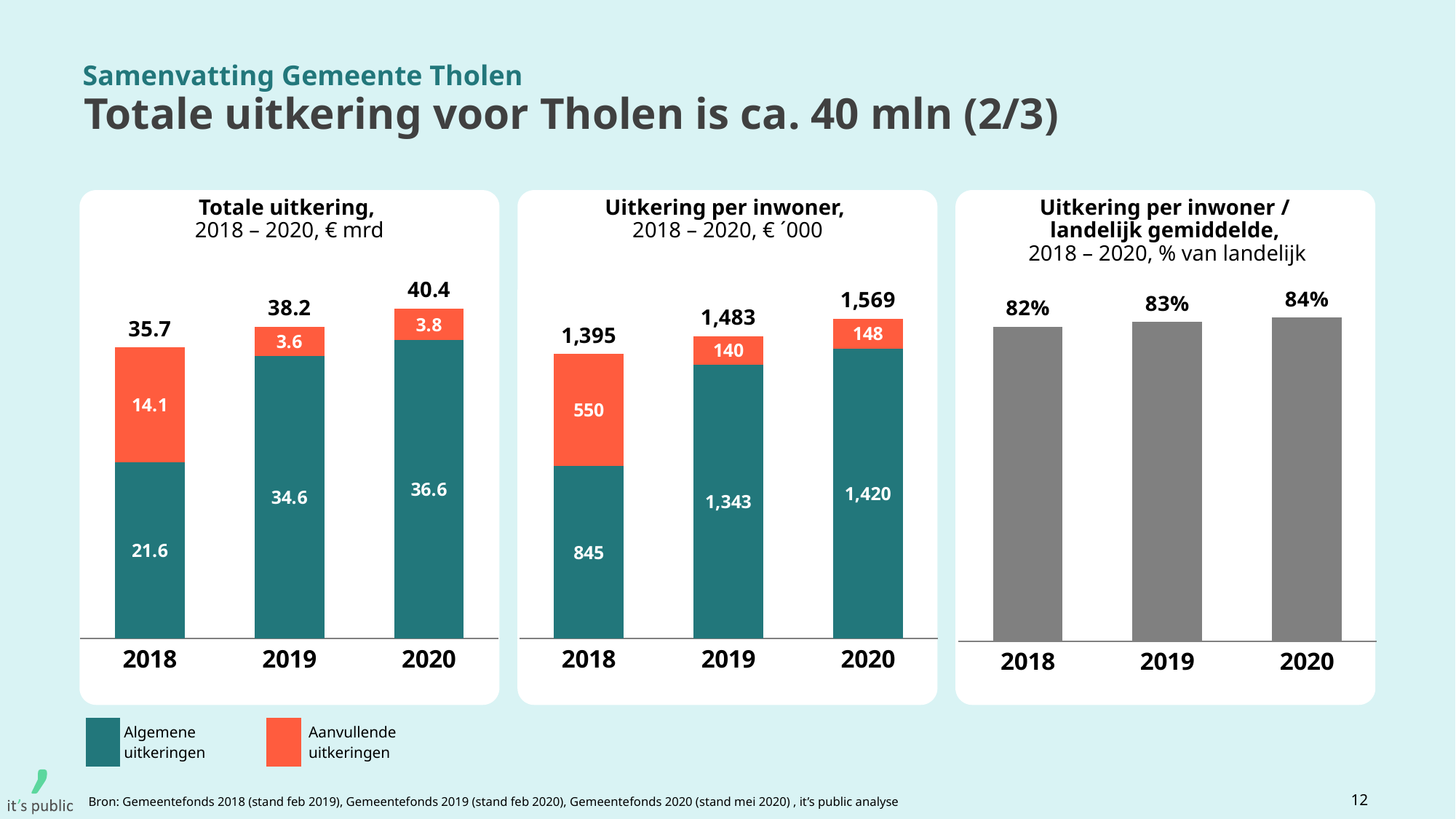
In the 'Uitkering per inwoner / landelijk gemiddelde' chart, which year has the highest value? 2020 In the 'Uitkering per inwoner / landelijk gemiddelde' chart, do the values rise or fall from 2018 to 2020? rise In the 'Totale uitkering' chart, what is the value of Algemene uitkeringen for 2019? 34.6 In the 'Totale uitkering' chart, what is the value of Aanvullende uitkeringen for 2018? 14.1 How many series does the legend at the bottom of the slide list? 2 In the 'Uitkering per inwoner' chart, which year has the lowest Aanvullende uitkeringen value? 2019 In the 'Uitkering per inwoner / landelijk gemiddelde' chart, what is the value for 2019? 83% In the 'Totale uitkering' chart, what is the total of the stacked bar for 2020? 40.4 In the 'Totale uitkering' chart, what is the difference between the Algemene uitkeringen values for 2020 and 2018? 15.0 What kind of chart is the 'Totale uitkering' chart? stacked bar chart In the 'Uitkering per inwoner' chart, what is the value of Algemene uitkeringen for 2020? 1,420 In the 'Uitkering per inwoner' chart, what is the total of the stacked bar for 2018? 1,395